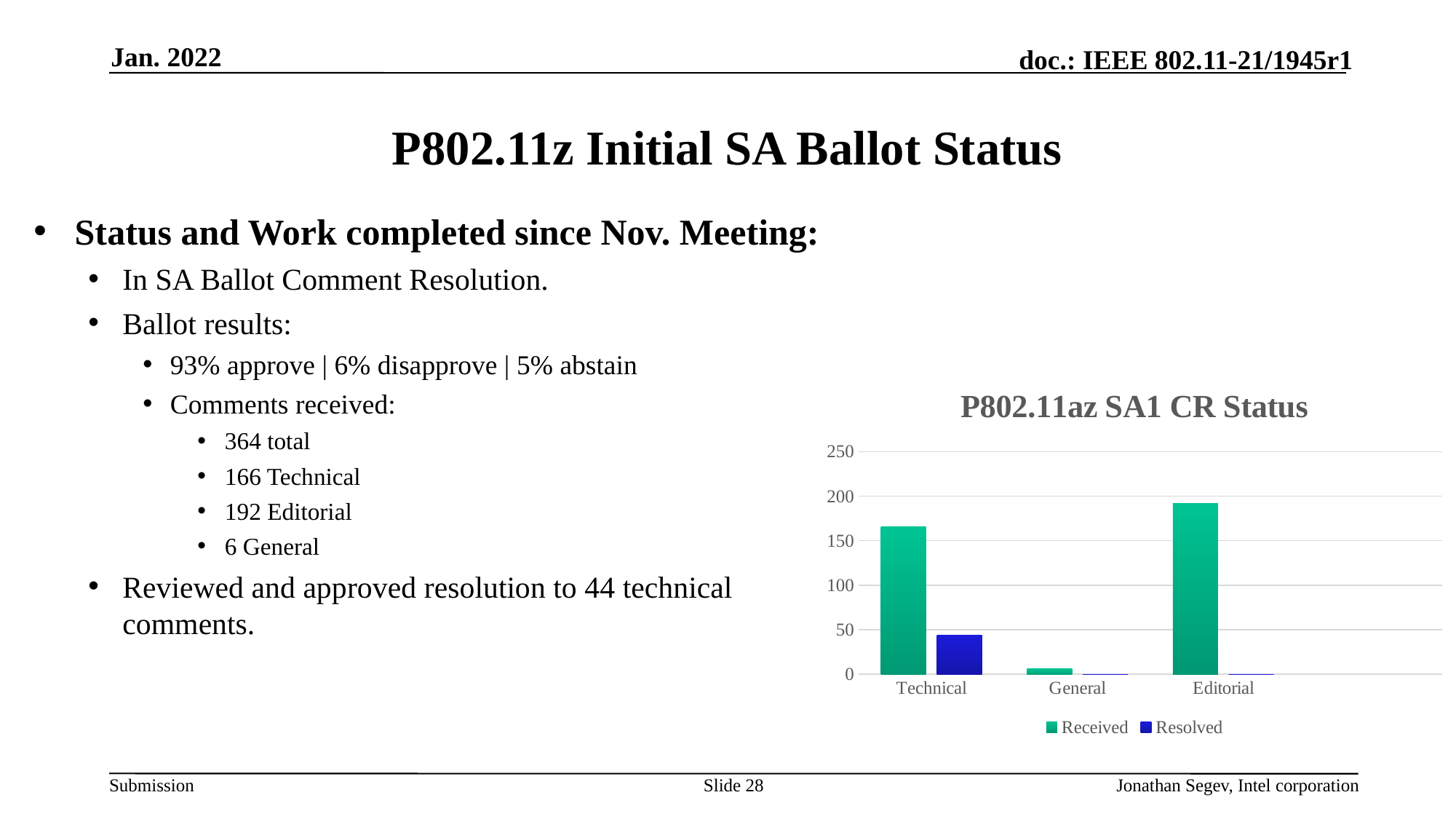
Which category has the highest Received value? Editorial Which category has the lowest Received value? General For the Technical category, which is larger: Received or Resolved? Received How many categories are shown on the x axis of the chart? 3 What is the title of the chart? P802.11az SA1 CR Status Is the Received value for Technical greater or less than 150? greater Is the Resolved value for Technical greater or less than 50? less Is the Received value for General greater or less than 50? less Which series is shown in dark blue in the chart legend? Resolved How many series does the chart legend list? 2 What kind of chart is shown on the slide? bar chart